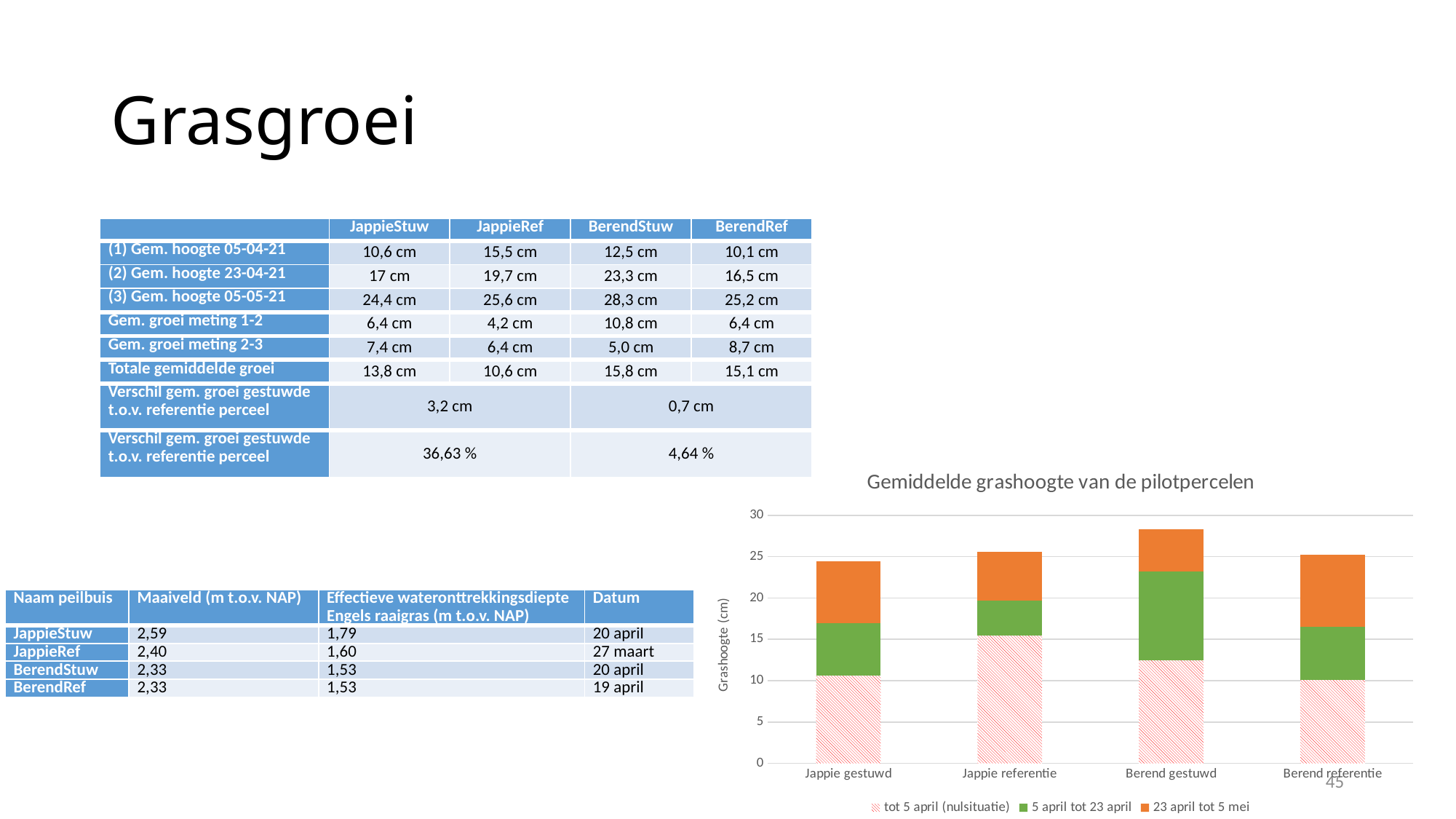
What kind of chart is shown on the slide? Stacked bar chart Which category has the largest 'tot 5 april (nulsituatie)' segment in the chart? Jappie referentie Is the total stacked bar for Berend gestuwd greater or less than 25? greater Is the total stacked bar for Jappie gestuwd greater or less than 20? greater Is the 'tot 5 april (nulsituatie)' segment for Berend gestuwd greater or less than 10? greater How many series does the chart's legend list? 3 Which category has the tallest stacked bar in the chart? Berend gestuwd What is the title of the chart on the slide? Gemiddelde grashoogte van de pilotpercelen Which stacked bar is taller in the chart: Berend gestuwd or Jappie referentie? Berend gestuwd How many categories are shown on the x axis of the chart? 4 Which legend entry in the chart is shown with a red hatched pattern? tot 5 april (nulsituatie)